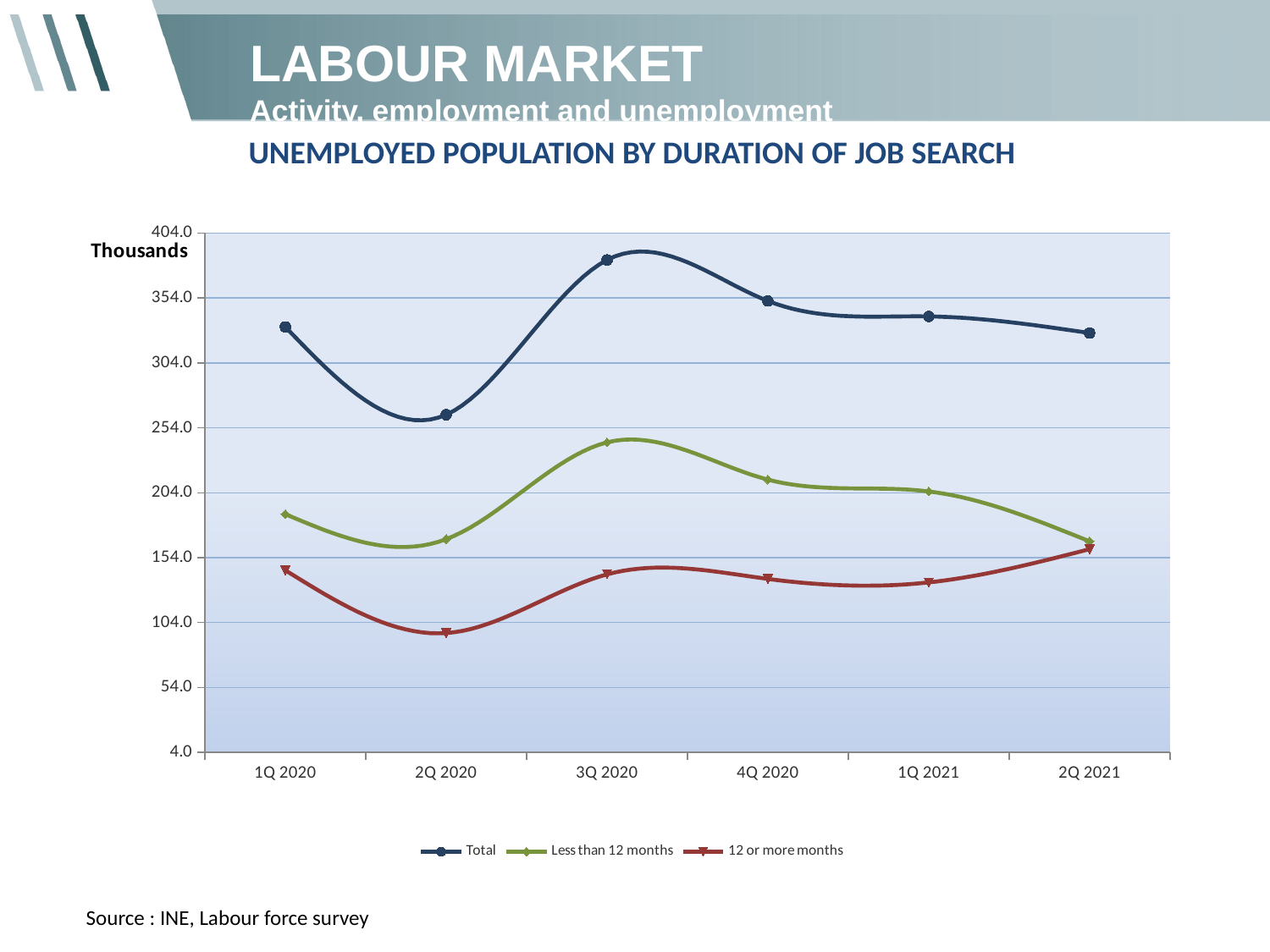
What kind of chart is shown on the slide? line chart Is the Total value for 3Q 2020 greater or less than 354.0? greater Which is larger for the Less than 12 months series: the value in 3Q 2020 or in 2Q 2021? 3Q 2020 In which quarter does the Total series reach its highest value? 3Q 2020 Does the Total series rise or fall from 3Q 2020 to 2Q 2021? fall Is the Total value for 2Q 2020 greater or less than 304.0? less Is the 12 or more months value for 2Q 2020 greater or less than 104.0? less In which quarter does the Total series reach its lowest value? 2Q 2020 How many quarters are plotted along the x axis? 6 How many series does the legend list? 3 In which quarter is the 12 or more months series at its lowest? 2Q 2020